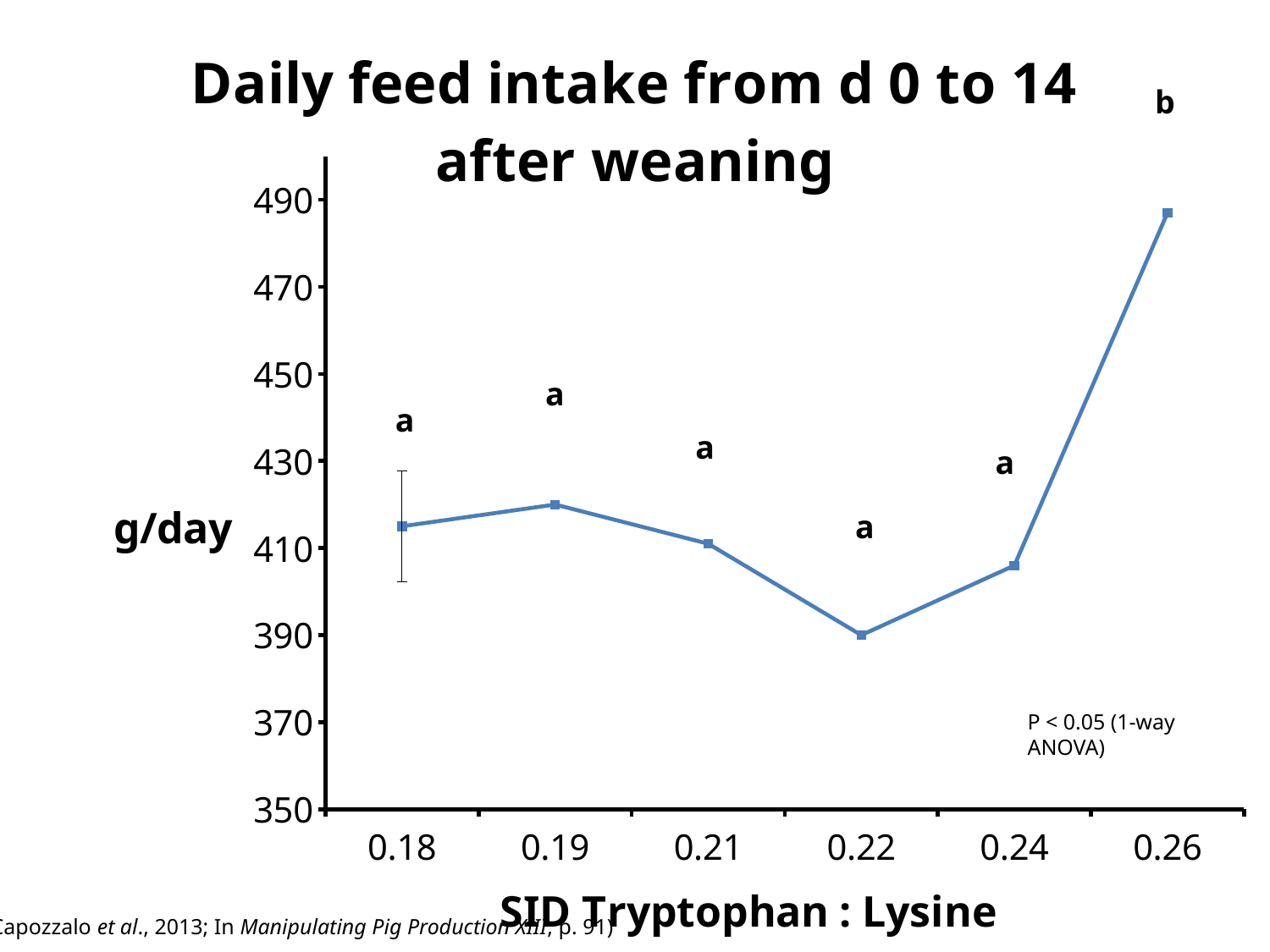
Is the daily feed intake at a ratio of 0.19 greater or less than 430 g/day? less How many SID Tryptophan : Lysine ratios are plotted on the x axis? 6 Which has the higher daily feed intake, a ratio of 0.19 or a ratio of 0.22? 0.19 What kind of chart is shown on the slide? line chart Does the daily feed intake rise or fall between the ratios 0.22 and 0.26? rise Is the daily feed intake at a ratio of 0.26 greater or less than 470 g/day? greater What is the label on the x axis of the chart? SID Tryptophan : Lysine Which SID Tryptophan : Lysine ratio has the lowest daily feed intake? 0.22 Is the daily feed intake at a ratio of 0.18 greater or less than 410 g/day? greater What is the title of the chart? Daily feed intake from d 0 to 14 after weaning Which SID Tryptophan : Lysine ratio has the highest daily feed intake? 0.26